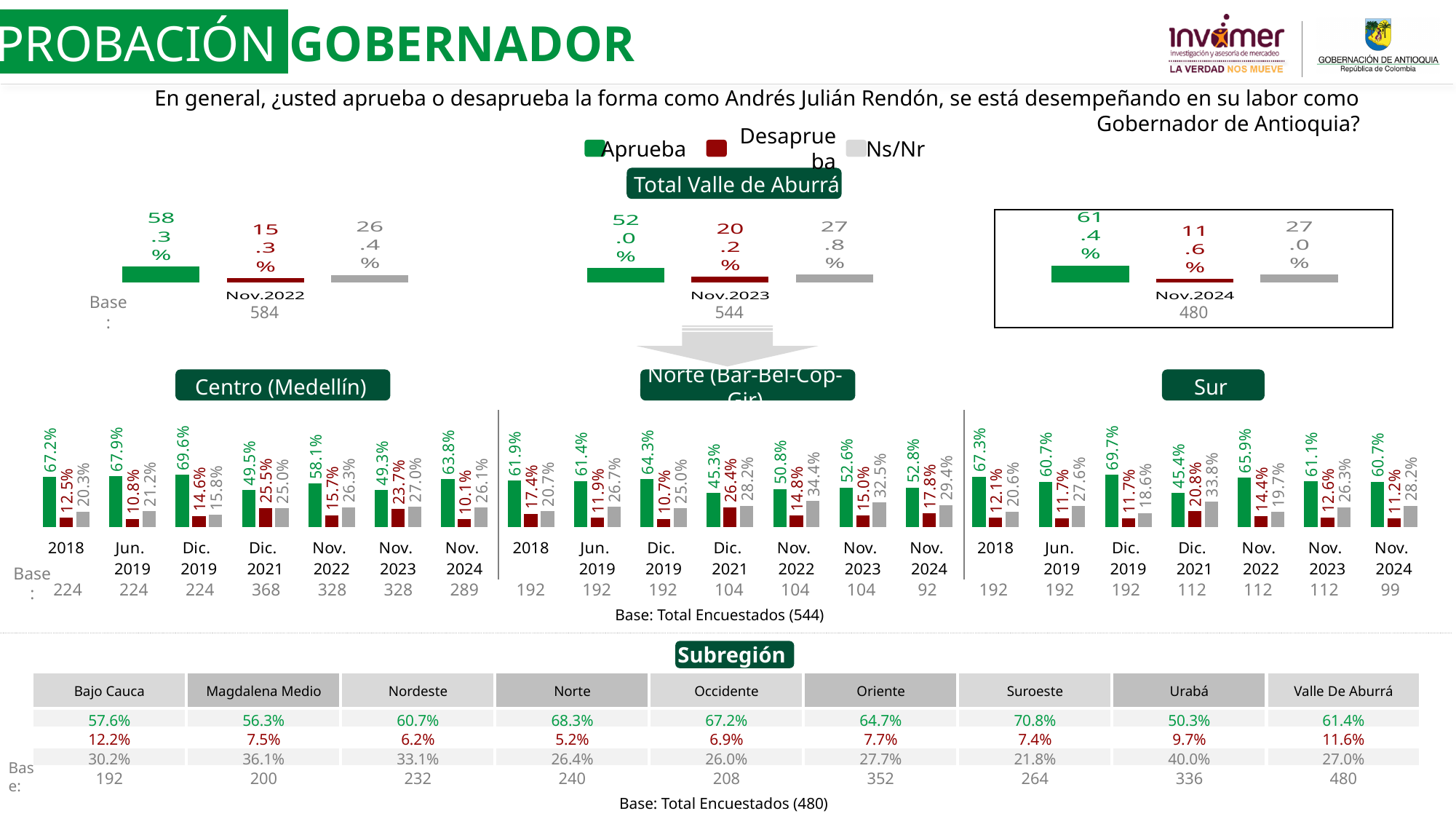
In the Centro (Medellín) chart, which period has the highest Aprueba value? Dic. 2019 In the Total Valle de Aburrá chart, what is the Aprueba value for Nov.2024? 61.4% In the Centro (Medellín) chart, which period has the lowest Aprueba value? Nov. 2023 In the Total Valle de Aburrá chart, by how many percentage points did Aprueba change from Nov.2023 to Nov.2024? 9.4 percentage points higher In the Total Valle de Aburrá chart, what is the Desaprueba value for Nov.2023? 20.2% In the Norte (Bar-Bel-Cop-Gir) chart, which period has the highest Desaprueba value? Dic. 2021 In the Norte (Bar-Bel-Cop-Gir) chart, what is the Ns/Nr value for Nov.2022? 34.4% In the Sur chart, what is the difference between the Aprueba values for Dic.2019 and Dic.2021? 24.3 percentage points In the Centro (Medellín) chart, what is the Aprueba value for Nov.2024? 63.8% How many time periods are shown in the Centro (Medellín) chart? 7 In the Sur chart, is the Aprueba value for Nov.2022 larger or smaller than the Aprueba value for Nov.2023? larger How many series does the legend list? 3